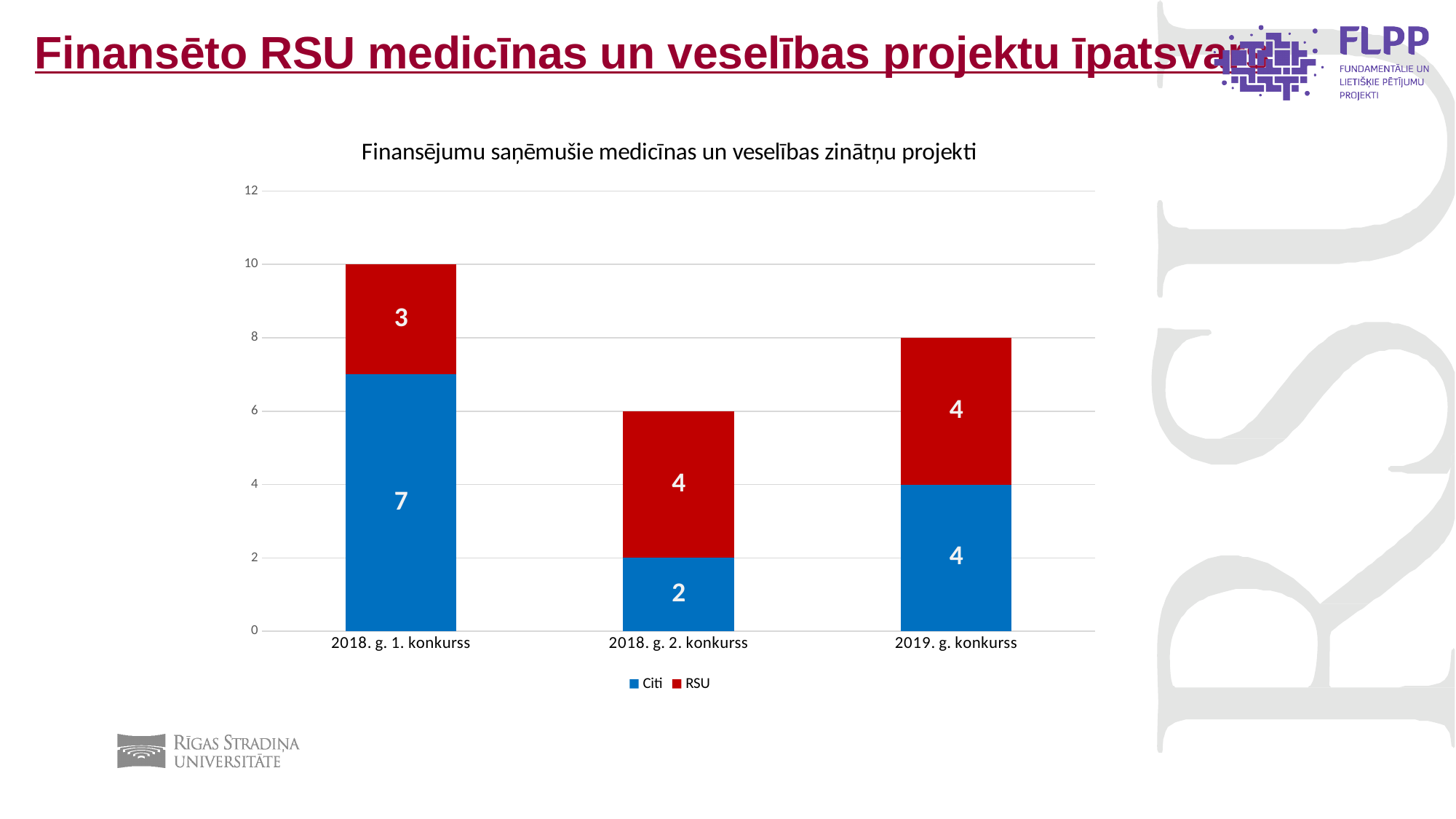
Which is larger in 2018. g. 2. konkurss, Citi or RSU? RSU What kind of chart is shown on the slide? Stacked bar chart How many series does the legend list? 2 Which category has the highest value for Citi? 2018. g. 1. konkurss What is the value for Citi in 2018. g. 1. konkurss? 7 What is the value for RSU in 2018. g. 2. konkurss? 4 What is the total of the stacked bar for 2018. g. 1. konkurss? 10 How many categories are shown on the x axis? 3 What is the total of the stacked bar for 2018. g. 2. konkurss? 6 What is the value for RSU in 2019. g. konkurss? 4 Which category has the lowest value for RSU? 2018. g. 1. konkurss What is the difference between the Citi value and the RSU value in 2018. g. 1. konkurss? 4